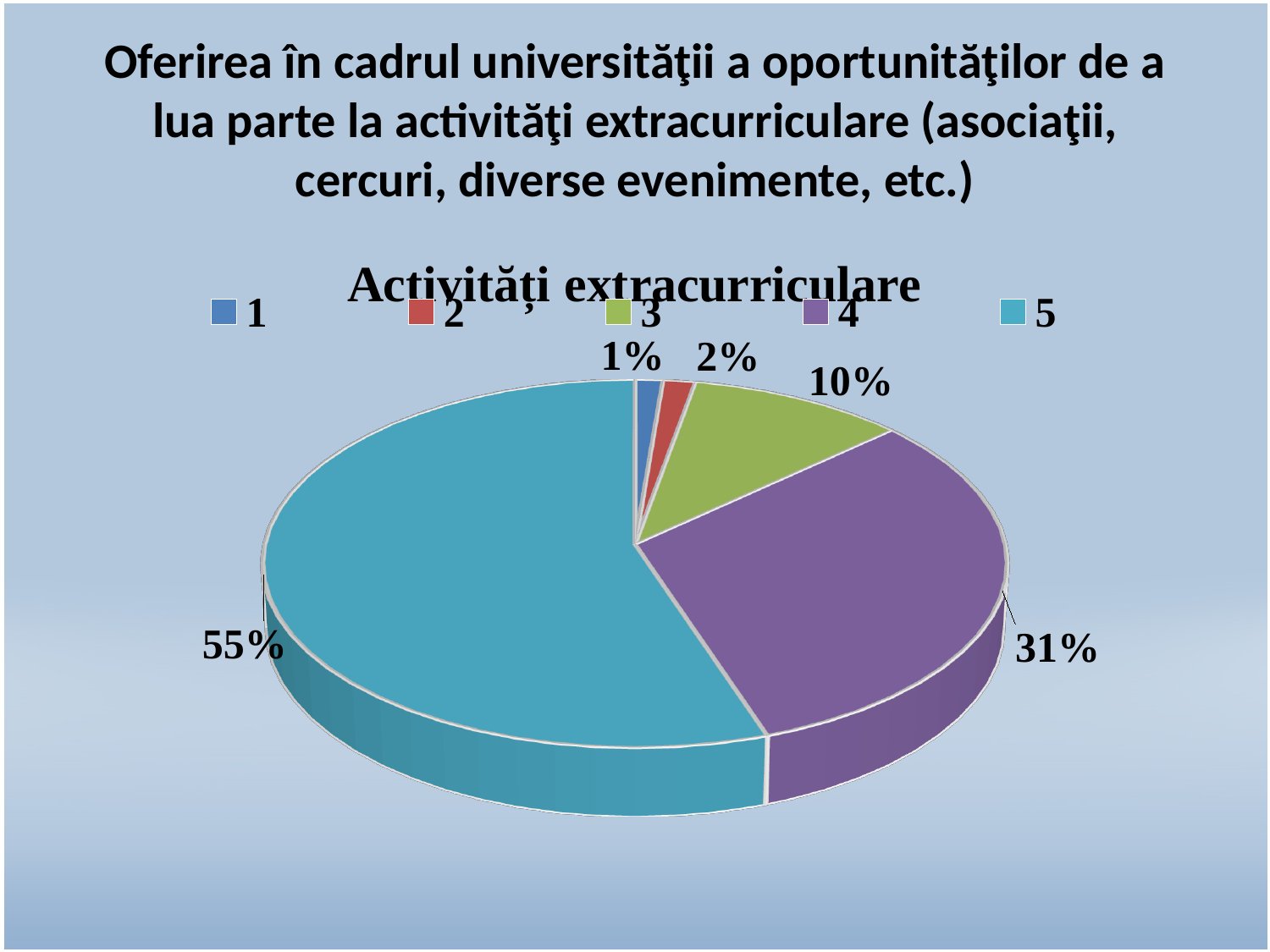
What is the difference between the shares of category 5 and category 4? 24% What share of the pie does category 4 have? 31% What kind of chart is shown on the slide? pie chart Which is larger, the share of category 3 or the share of category 4? category 4 What is the value for category 2? 2% What is the value for category 3? 10% What is the value for category 1? 1% Which category has the largest slice? 5 How many categories does the legend list? 5 What share of the pie does category 5 have? 55% What is the chart's title? Activități extracurriculare Which category has the smallest slice? 1